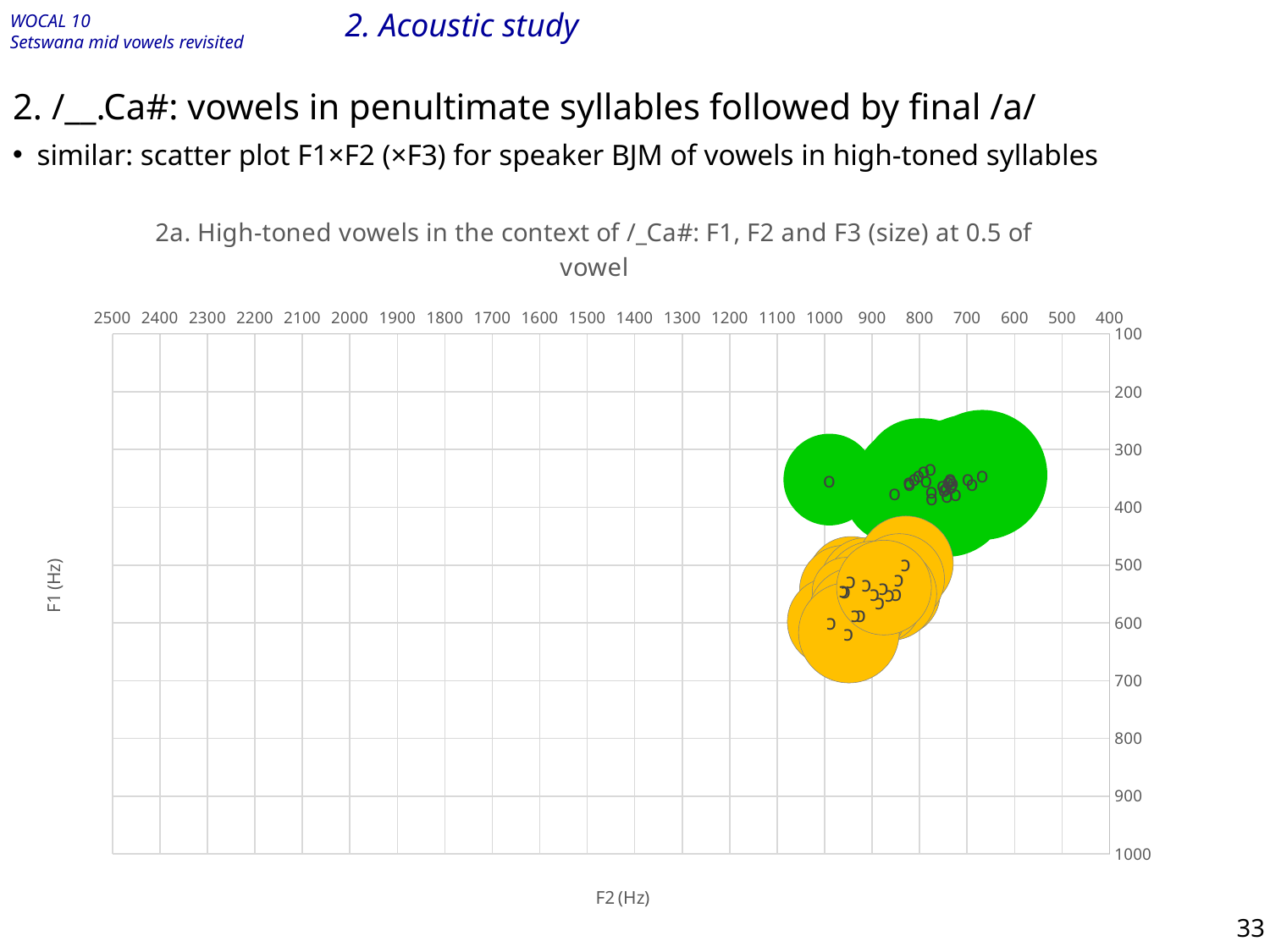
Are the F2 values of the green bubbles greater or less than 1300? less Are the F2 values of the orange bubbles greater or less than 1200? less Which vowel symbol is printed inside the orange bubbles? ɔ Are the F1 values of the orange bubbles greater or less than 400? greater What kind of chart is shown on the slide? Bubble (scatter) chart How many differently coloured groups of bubbles are plotted on the chart? 2 What is the label of the vertical axis of the chart? F1 (Hz) What is the largest value shown on the F1 (Hz) axis? 1000 Which group of bubbles has the higher F1 values, the green group or the orange group? the orange group What is the title of the chart? 2a. High-toned vowels in the context of /_Ca#: F1, F2 and F3 (size) at 0.5 of vowel